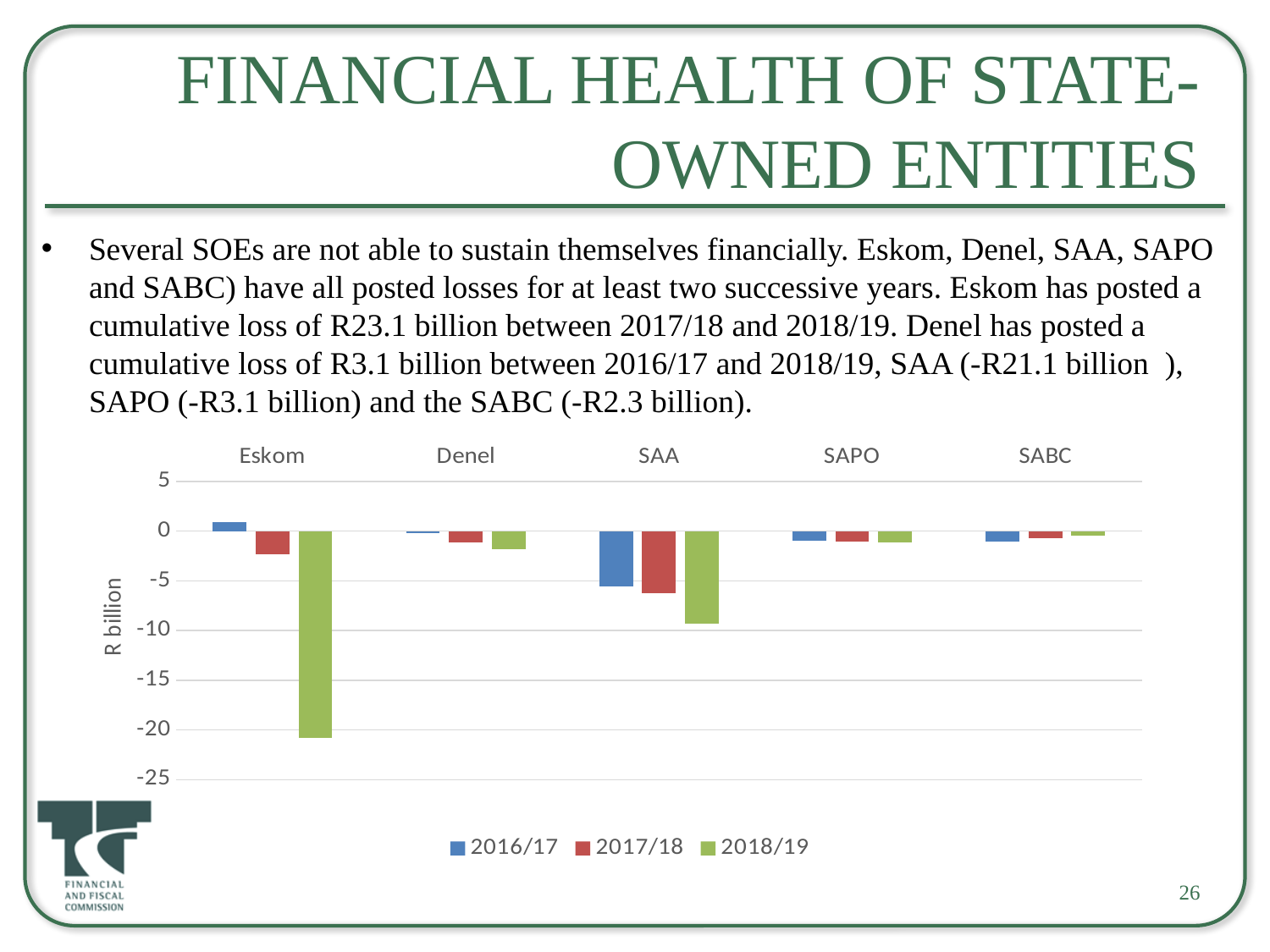
What is the label on the y axis of the chart? R billion How many state-owned entities are shown on the x axis of the chart? 5 Which entity has the highest value for 2016/17 in the chart? Eskom Do Eskom's values rise or fall from 2016/17 to 2018/19? fall For SAA, which year has the lowest value? 2018/19 Is the 2018/19 value for SAA greater or less than -5? less How many series does the chart legend list? 3 Which entity has the lowest value for 2018/19 in the chart? Eskom What type of chart is shown on the slide? bar chart Is the 2018/19 value for Eskom greater or less than -15? less Is the 2016/17 value for Eskom greater or less than 0? greater Which is lower, the 2018/19 value for Eskom or the 2018/19 value for SAA? Eskom